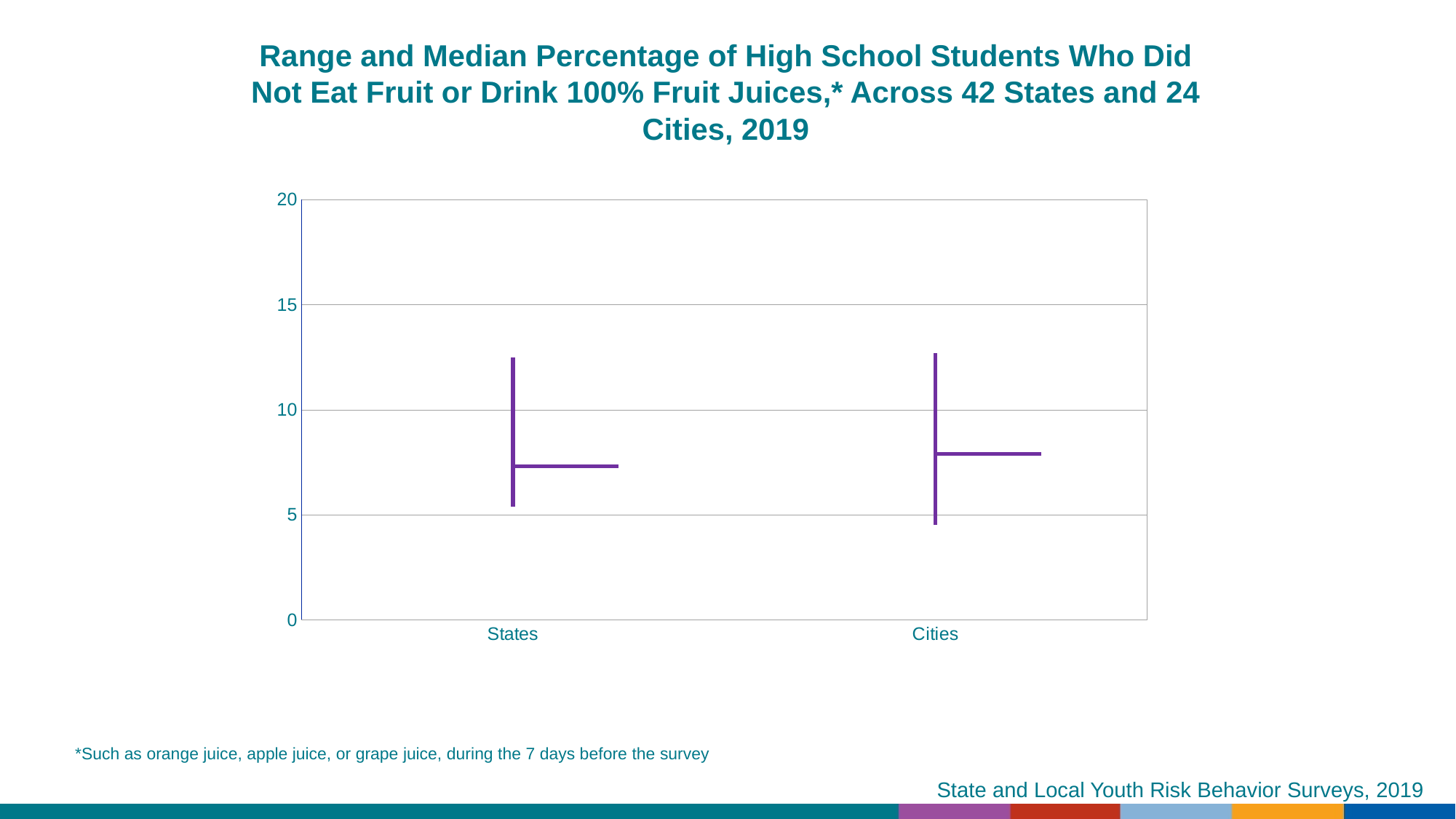
Which category has the lower bottom of its range, States or Cities? Cities Is the median value for Cities greater or less than 10? less How many categories are shown on the x axis of the chart? 2 What colour are the range and median lines in the chart? Purple Is the median value for States greater or less than 5? greater Is the top of the range for States greater or less than 10? greater What is the highest value shown on the y axis of the chart? 20